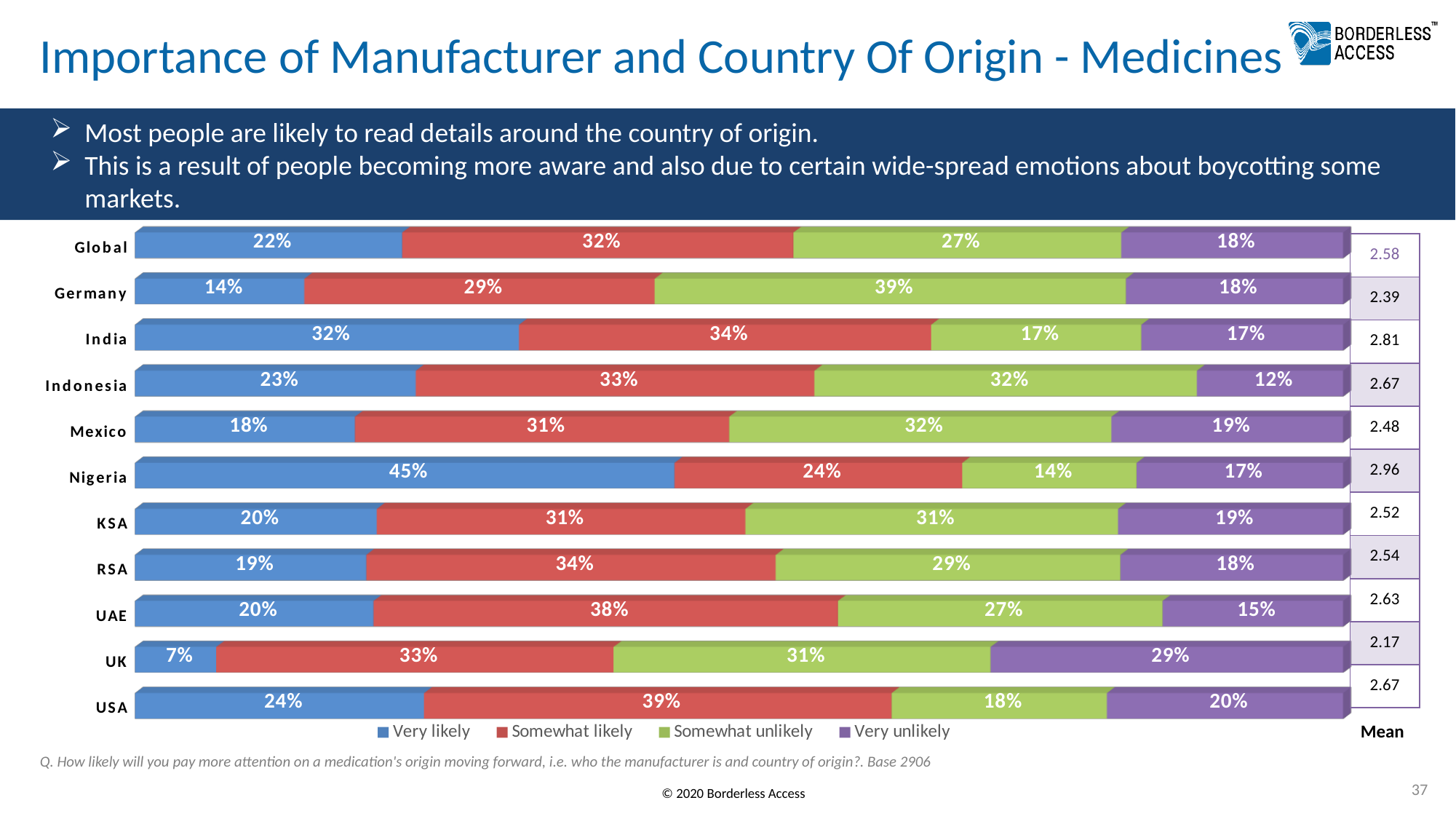
What is the total of the stacked bar for Germany? 100% Which country has the lowest 'Very likely' share? UK Which country has the highest 'Very likely' share? Nigeria How many categories (rows) are shown in the chart? 11 What is the 'Very likely' value for the UK? 7% How many series does the legend list? 4 What percentage of respondents in Nigeria are 'Very likely' to pay more attention to a medication's origin? 45% Which country has the highest 'Very unlikely' share? UK What is the difference in percentage points between the 'Very likely' values for Nigeria and the UK? 38 percentage points Which has a larger 'Somewhat likely' value, UAE or Mexico? UAE What is the 'Somewhat unlikely' value for Germany? 39% What is the 'Somewhat likely' value for the USA? 39%